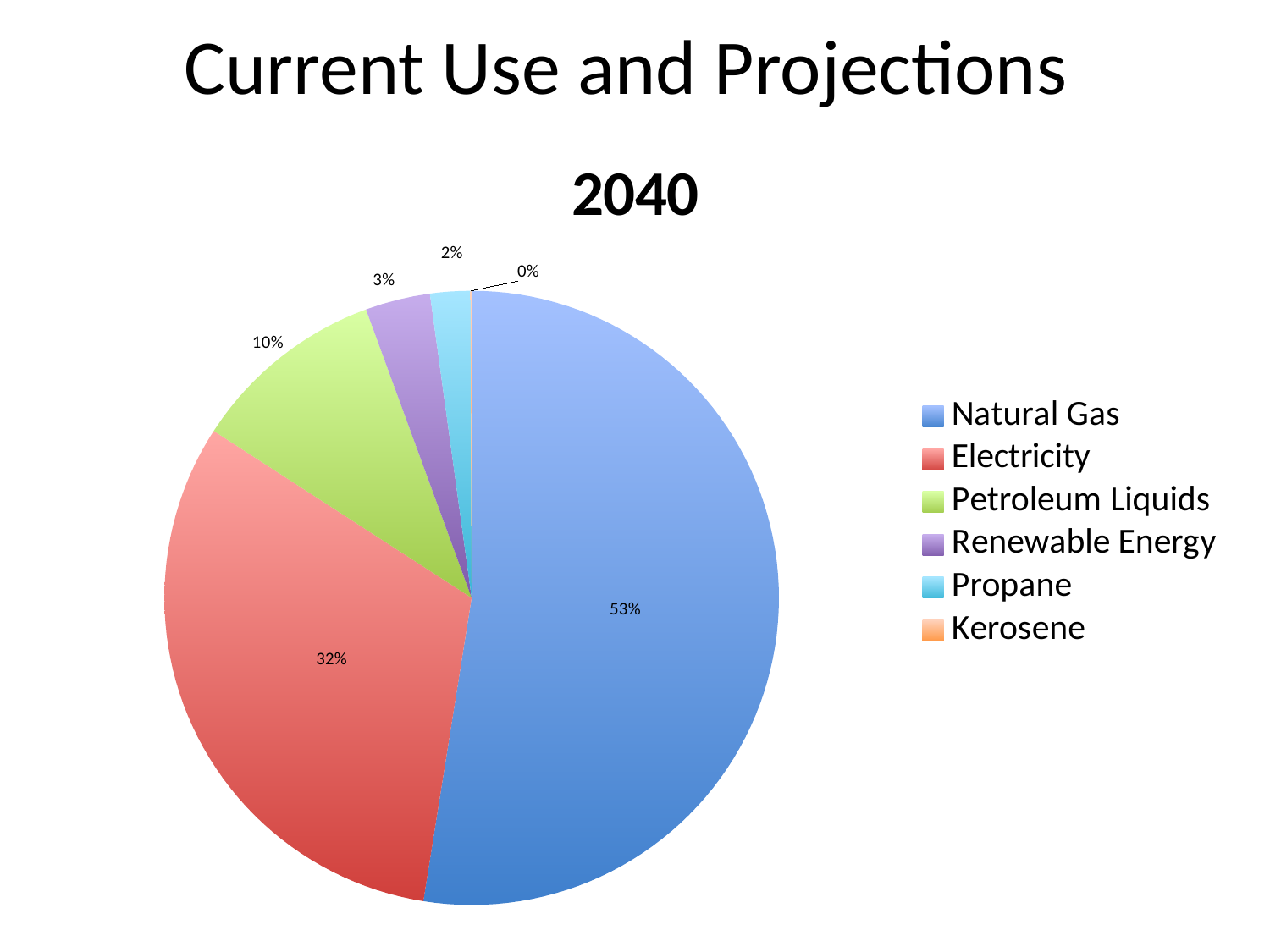
Which is larger, the share for Petroleum Liquids or the share for Renewable Energy? Petroleum Liquids What kind of chart is shown on the slide? Pie chart What is the difference in percentage points between Natural Gas and Electricity? 21 What share of the pie does Propane have? 2% Which category has the smallest slice of the pie? Kerosene Which category has the largest slice of the pie? Natural Gas How many categories does the legend list? 6 What share of the pie does Natural Gas have? 53% What share of the pie does Petroleum Liquids have? 10%